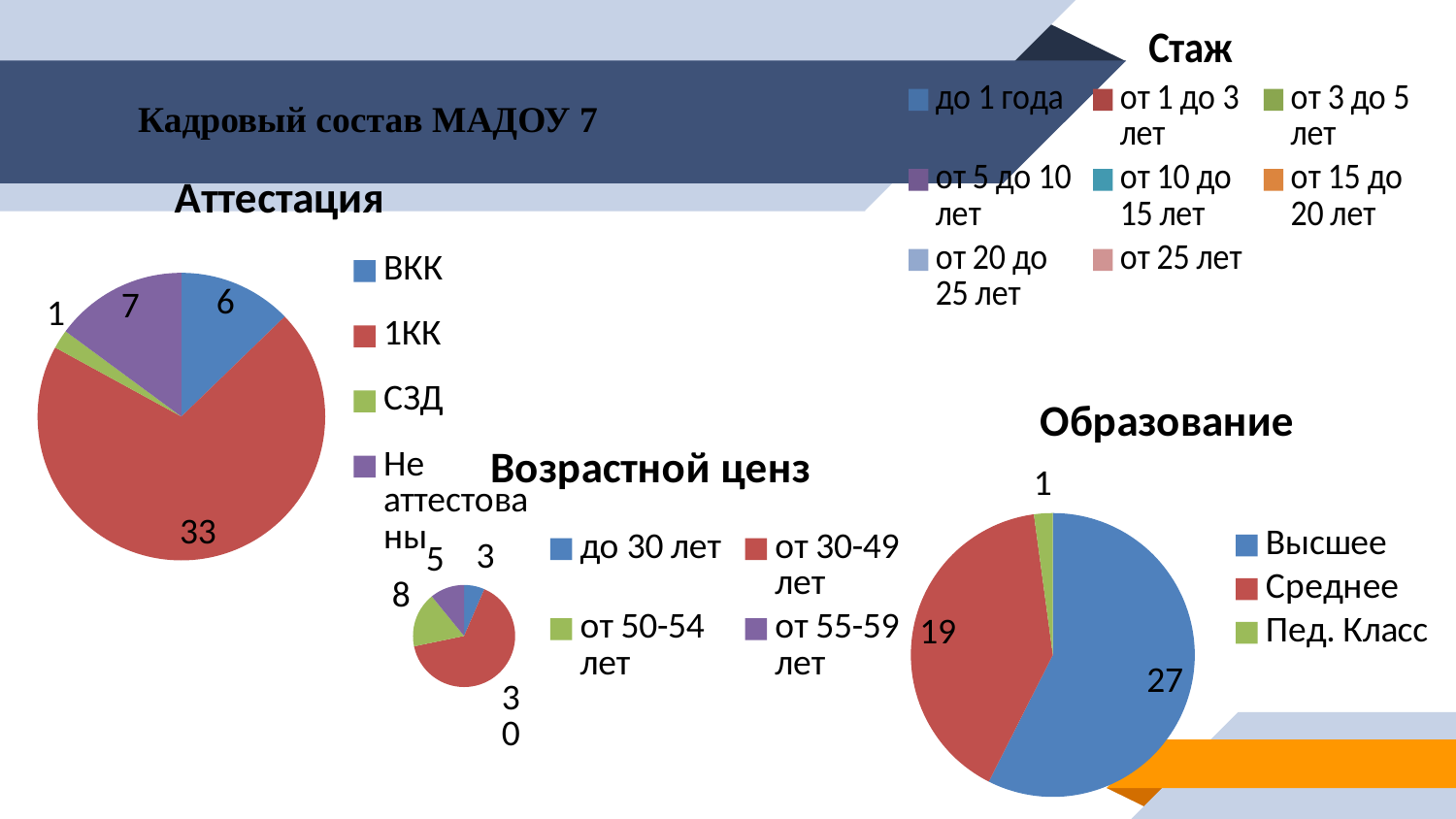
In the Возрастной ценз pie chart, which is larger: от 50-54 лет or от 55-59 лет? от 50-54 лет In the Возрастной ценз pie chart, which category has the largest value? от 30-49 лет In the Аттестация pie chart, what is the difference between the values for 1КК and ВКК? 27 In the Образование pie chart, which category has the largest value? Высшее In the Аттестация pie chart, what is the value for 1КК? 33 What type of chart is the Образование chart? pie chart In the Аттестация pie chart, which category has the smallest value? СЗД In the Образование pie chart, what is the difference between Высшее and Среднее? 8 In the Образование pie chart, what is the value for Среднее? 19 In the Аттестация pie chart, how many categories are shown? 4 In the Возрастной ценз pie chart, what is the value for от 30-49 лет? 30 How many entries does the legend of the Стаж chart list? 8